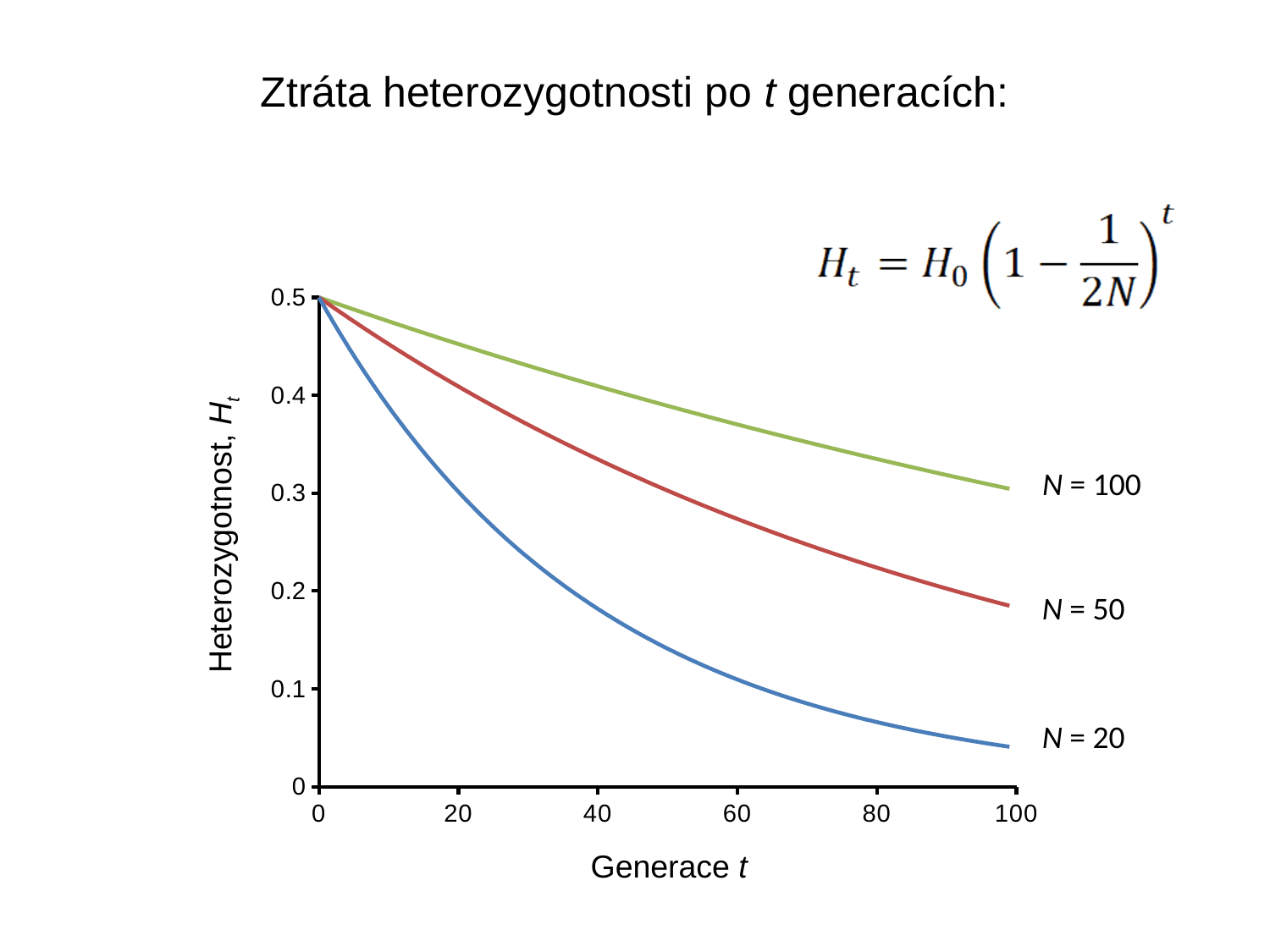
How many curves (series) are plotted on the chart? 3 What is the label of the x axis? Generace t What kind of chart is shown on the slide? Line chart Is the value for N = 20 at generation 100 greater or less than 0.1? less Is the value for N = 100 at generation 100 greater or less than 0.2? greater Is the value for N = 50 at generation 100 greater or less than 0.1? greater Which curve has the lowest heterozygosity at generation 100? N = 20 Which curve has the highest heterozygosity at generation 100? N = 100 Do the curves rise or fall as generation t increases? Fall At generation 60, which curve has the larger value, N = 50 or N = 20? N = 50 What colour is the curve for N = 20? Blue What is the heterozygosity value of all three curves at generation 0? 0.5